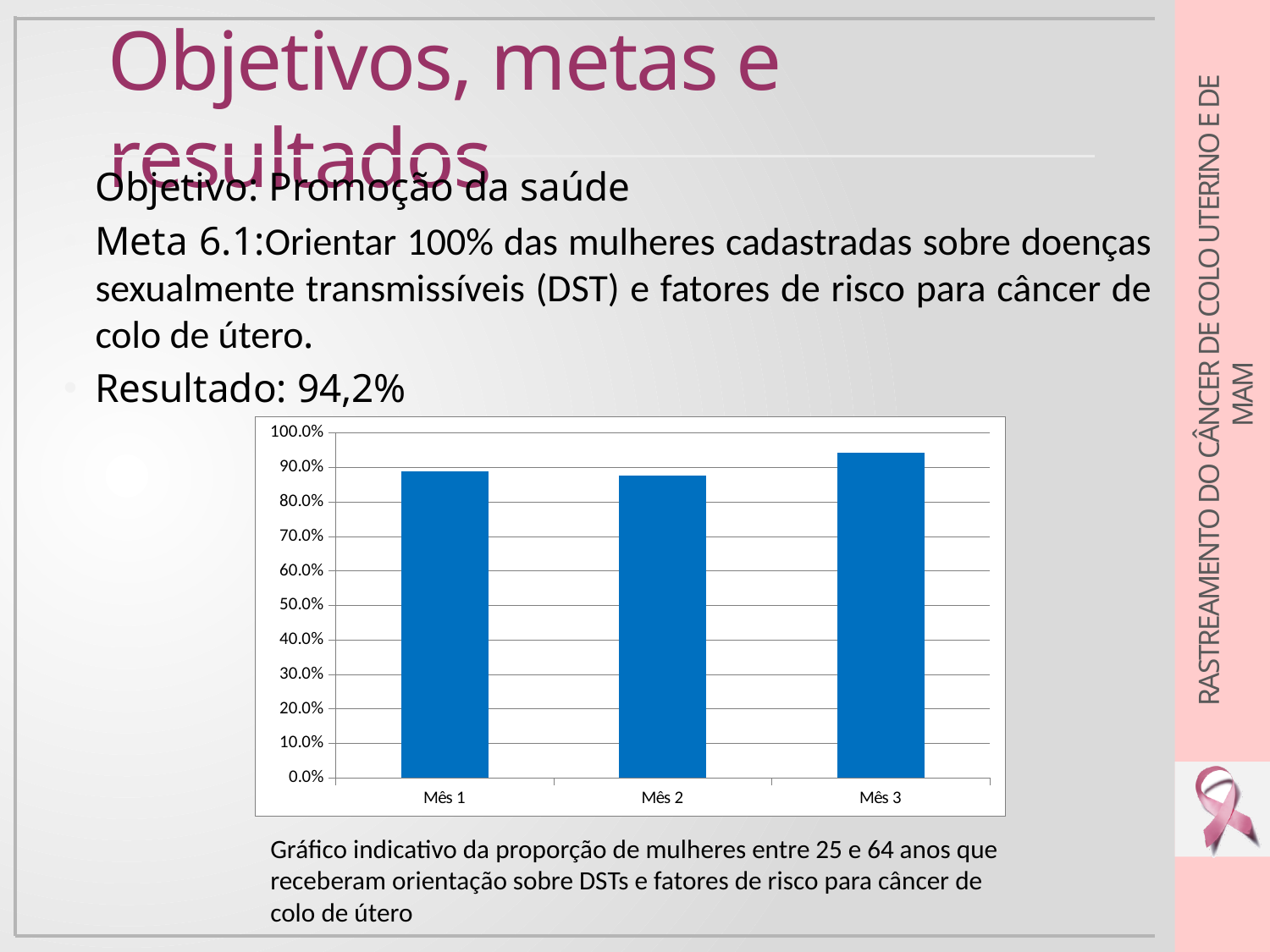
Is the value for Mês 1 greater or less than 80.0%? greater Is the value for Mês 2 greater or less than 50.0%? greater Which is larger, the value for Mês 3 or the value for Mês 2? Mês 3 What are the category labels on the x axis of the chart? Mês 1, Mês 2, Mês 3 Which is larger, the value for Mês 3 or the value for Mês 1? Mês 3 How many categories (months) are plotted on the chart? 3 Is the value for Mês 2 greater or less than 90.0%? less What kind of chart is shown on the slide? bar chart Which month has the highest value on the chart? Mês 3 What is the highest value shown on the chart's vertical axis? 100.0%